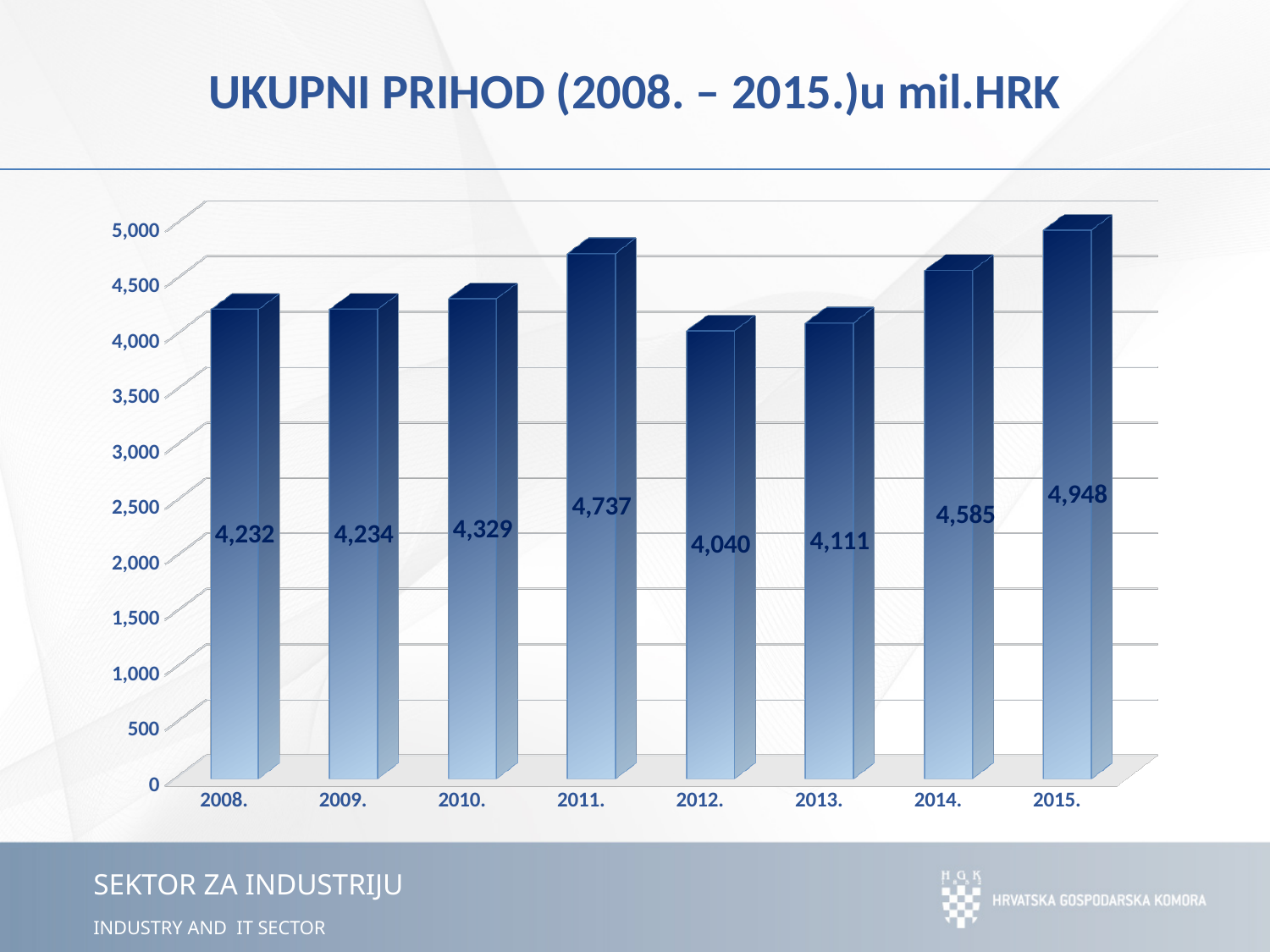
What is the value for 2012.? 4,040 What kind of chart is shown on the slide? bar chart What is the value for 2011.? 4,737 Which year has the lowest value? 2012. What is the difference between the values for 2015. and 2014.? 363 What is the difference between the values for 2011. and 2012.? 697 What is the title of the chart? UKUPNI PRIHOD (2008. – 2015.)u mil.HRK What is the value for 2015.? 4,948 How many years are shown on the x axis? 8 Which is larger, the value for 2010. or the value for 2013.? 2010. Which year has the highest value? 2015. Is the value for 2014. greater or less than 4,500? greater